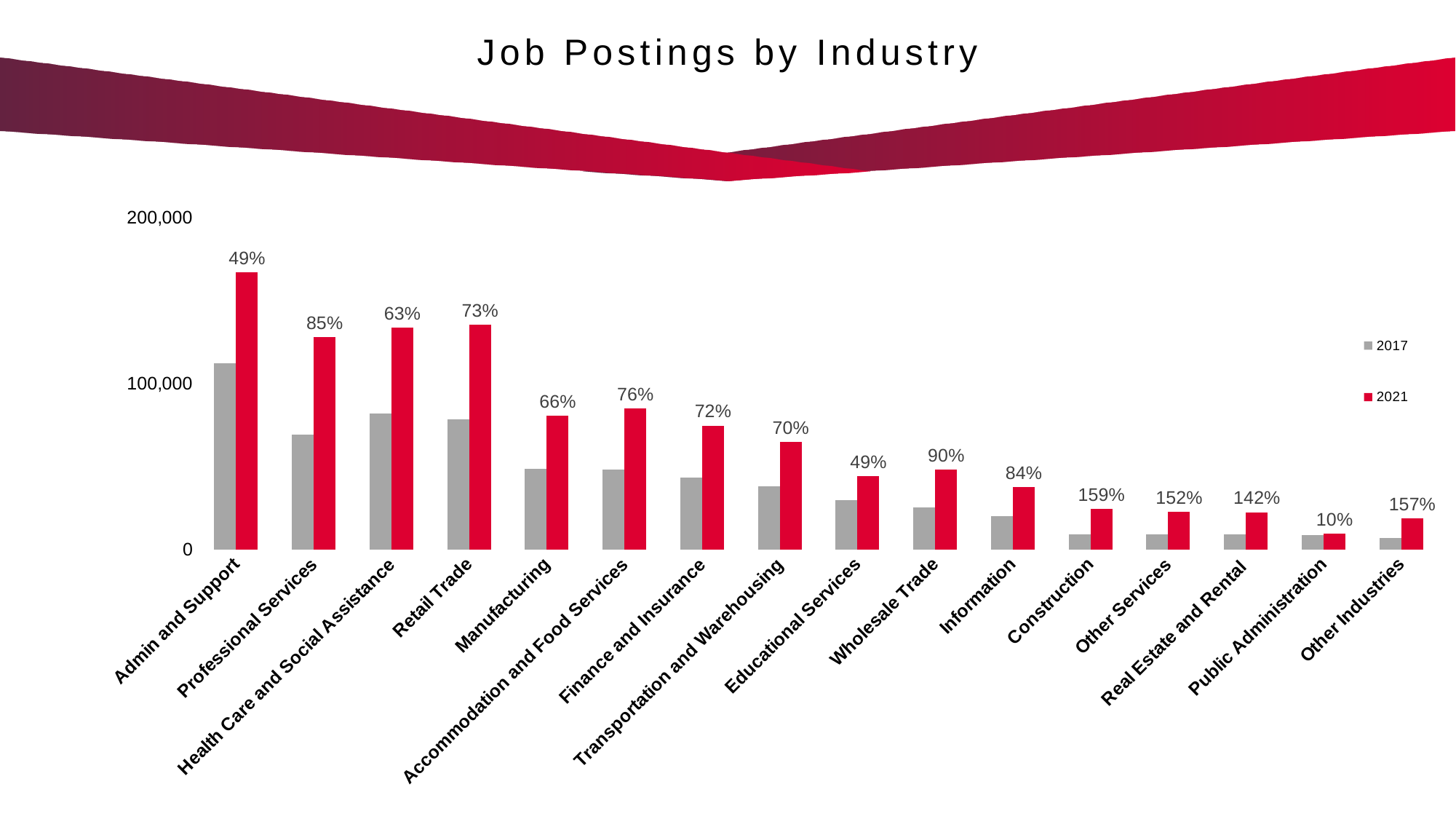
What percentage label is shown above the 2021 bar for Wholesale Trade? 90% Is the 2021 value for Admin and Support greater or less than 100,000? greater How many series does the legend list? 2 How many industries are shown on the x axis? 16 Which industry has the tallest 2021 bar? Admin and Support Is the 2021 value for Manufacturing greater or less than 100,000? less Which industry has the highest percentage label? Construction Which industry has the lowest percentage label? Public Administration Which series is shown in red in the legend? 2021 What percentage label is shown above the 2021 bar for Professional Services? 85% What percentage label is shown above the 2021 bar for Public Administration? 10% What kind of chart is shown on the slide? Bar chart